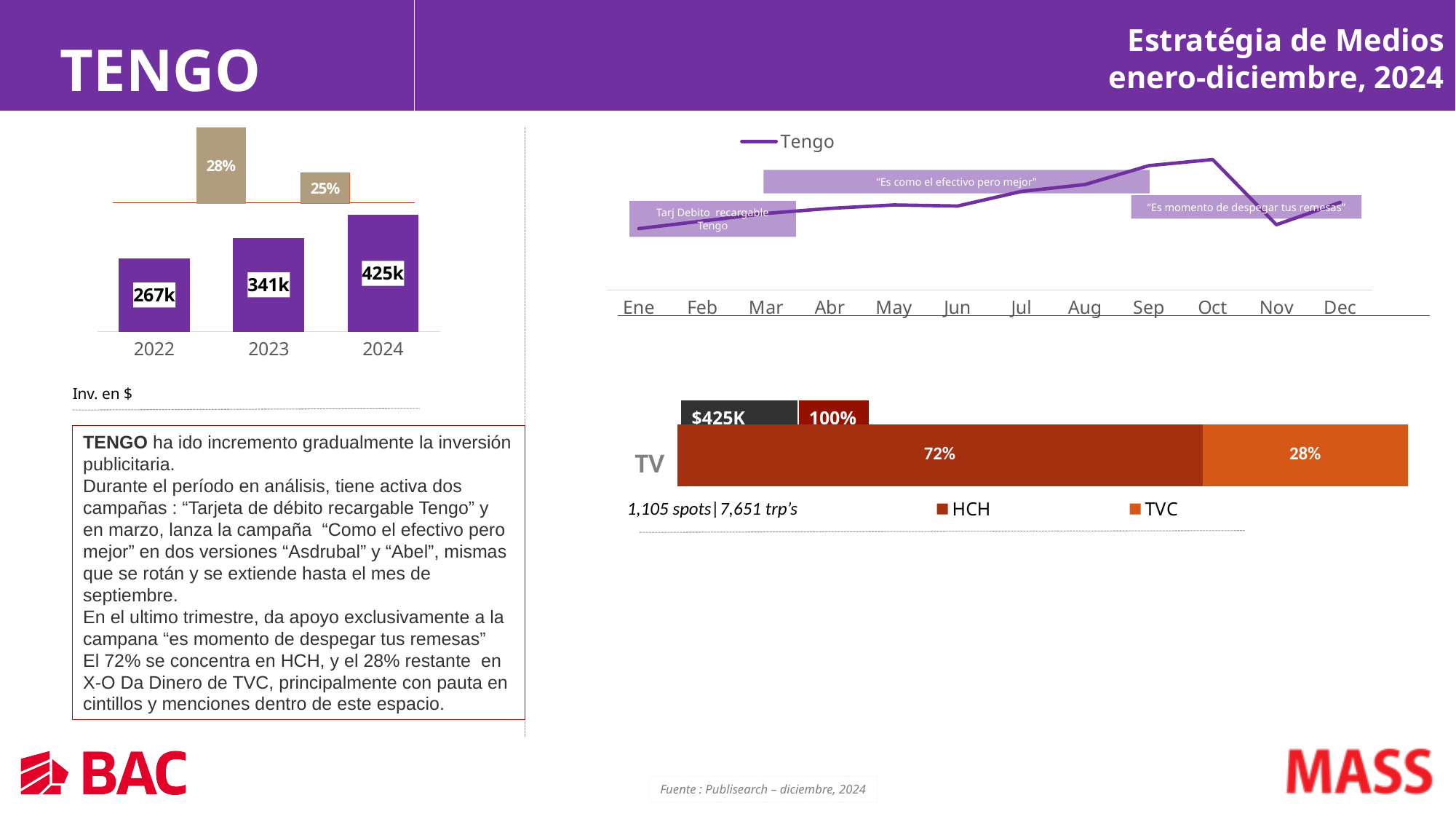
What type of chart is the monthly Tengo chart on the top right? line chart In the bar chart on the left, which year has the lowest investment? 2022 In the bar chart on the left, what is the difference between the 2024 and 2022 values? 158k In the Tengo line chart on the top right, which month has the highest value? Oct In the bar chart on the left, what is the value for 2022? 267k In the bar chart on the left, which year has the highest investment? 2024 In the TV stacked bar chart, what is the difference between the HCH and TVC shares? 44% In the bar chart on the left, do the investment values rise or fall from 2022 to 2024? rise In the bar chart on the left, what growth percentage is shown above the 2023 bar? 28% How many months are shown on the x axis of the Tengo line chart on the top right? 12 In the TV stacked bar chart, what share does HCH have? 72% In the bar chart on the left, what is the value for 2024? 425k